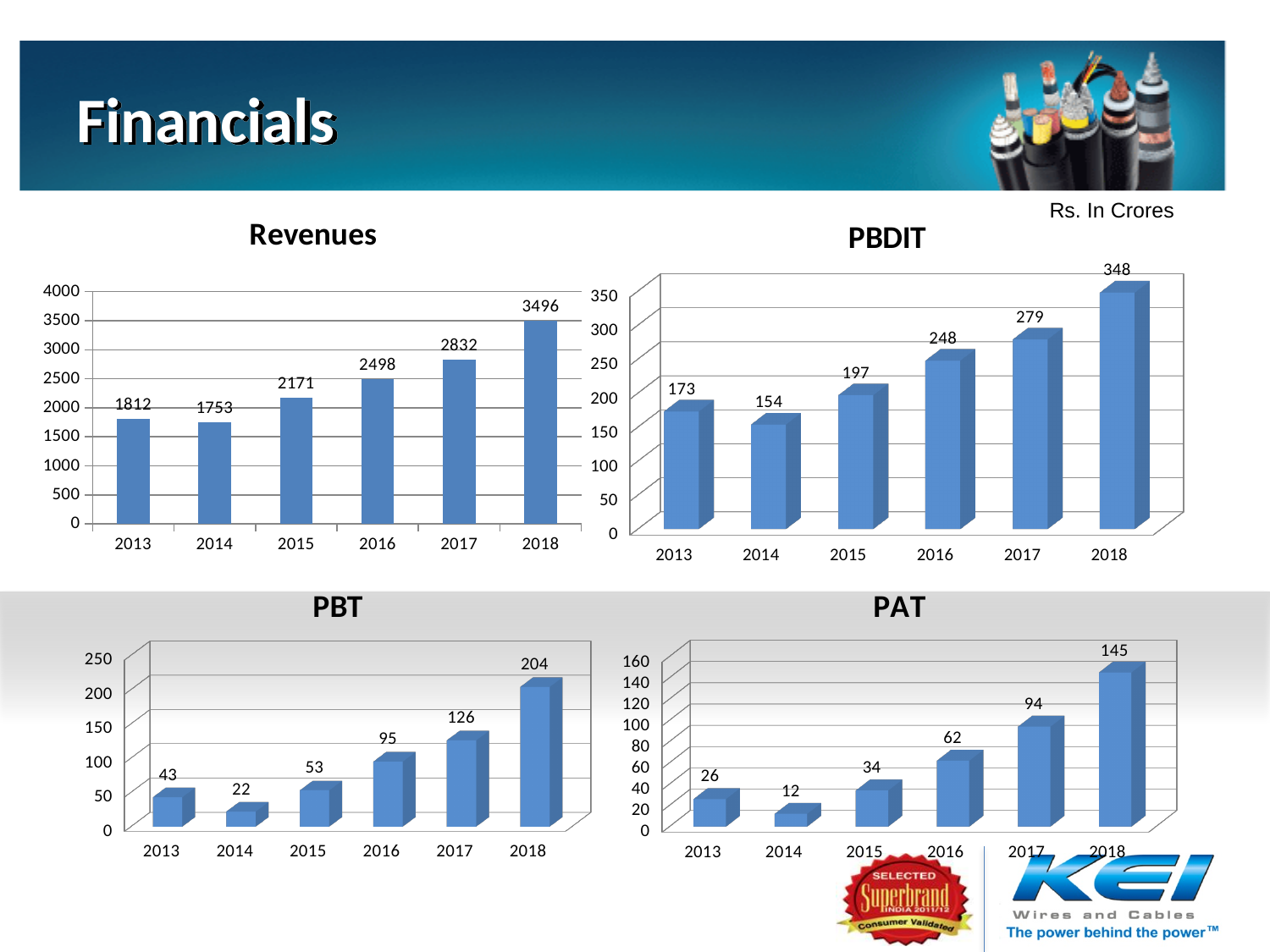
In the PBDIT chart, what is the value for 2015? 197 What kind of chart is the PAT chart? bar chart In the PAT chart, what is the value for 2016? 62 In the PBT chart, do the values generally rise or fall from 2014 to 2018? rise In the PAT chart, which year has the highest value? 2018 In the Revenues chart, what is the value for 2018? 3496 In the PBDIT chart, which is larger, the value for 2013 or the value for 2014? 2013 In the Revenues chart, what is the difference between the 2017 and 2016 values? 334 What unit is stated for the values on the slide? Rs. In Crores How many years are shown on the x axis of the PBT chart? 6 In the PAT chart, what is the difference between the 2018 and 2017 values? 51 In the PBT chart, which year has the lowest value? 2014